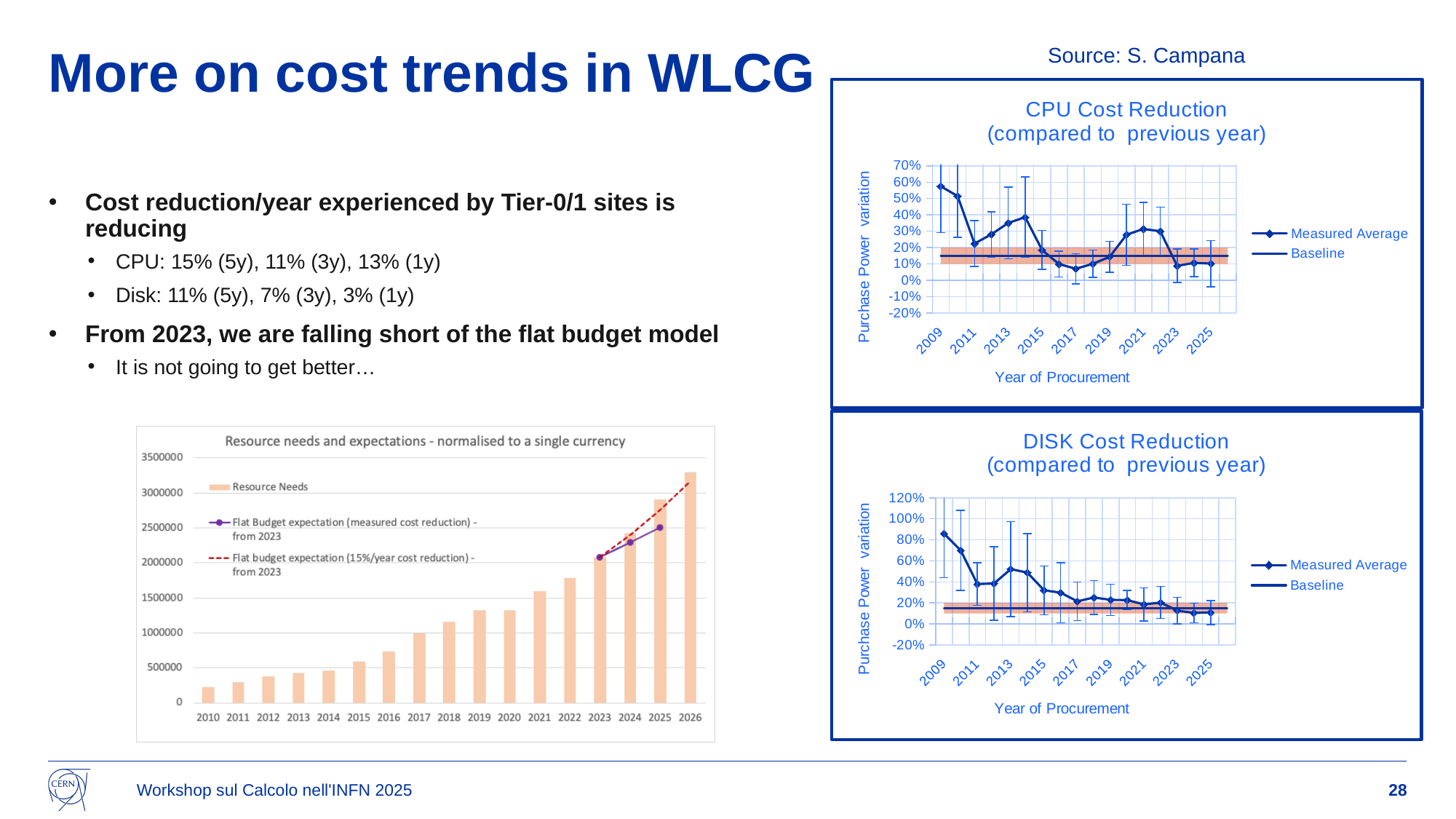
In the 'Resource needs and expectations' chart, is the Resource Needs value for 2026 greater or less than 3000000? greater In the 'DISK Cost Reduction' chart, is the Measured Average value for 2025 greater or less than 20%? less In the 'CPU Cost Reduction' chart, is the Measured Average value for 2009 greater or less than 50%? greater How many entries does the legend of the 'Resource needs and expectations' chart list? 3 In the 'Resource needs and expectations' chart, which year has the lowest Resource Needs bar? 2010 In the 'CPU Cost Reduction' chart, which year has the highest Measured Average value? 2009 How many years are shown on the x axis of the 'Resource needs and expectations' chart? 17 In the 'DISK Cost Reduction' chart, which is larger, the Measured Average for 2013 or for 2023? 2013 In the 'Resource needs and expectations' chart, which year has the highest Resource Needs bar? 2026 What kind of chart is the 'Resource needs and expectations - normalised to a single currency' chart? bar chart (with line overlays)